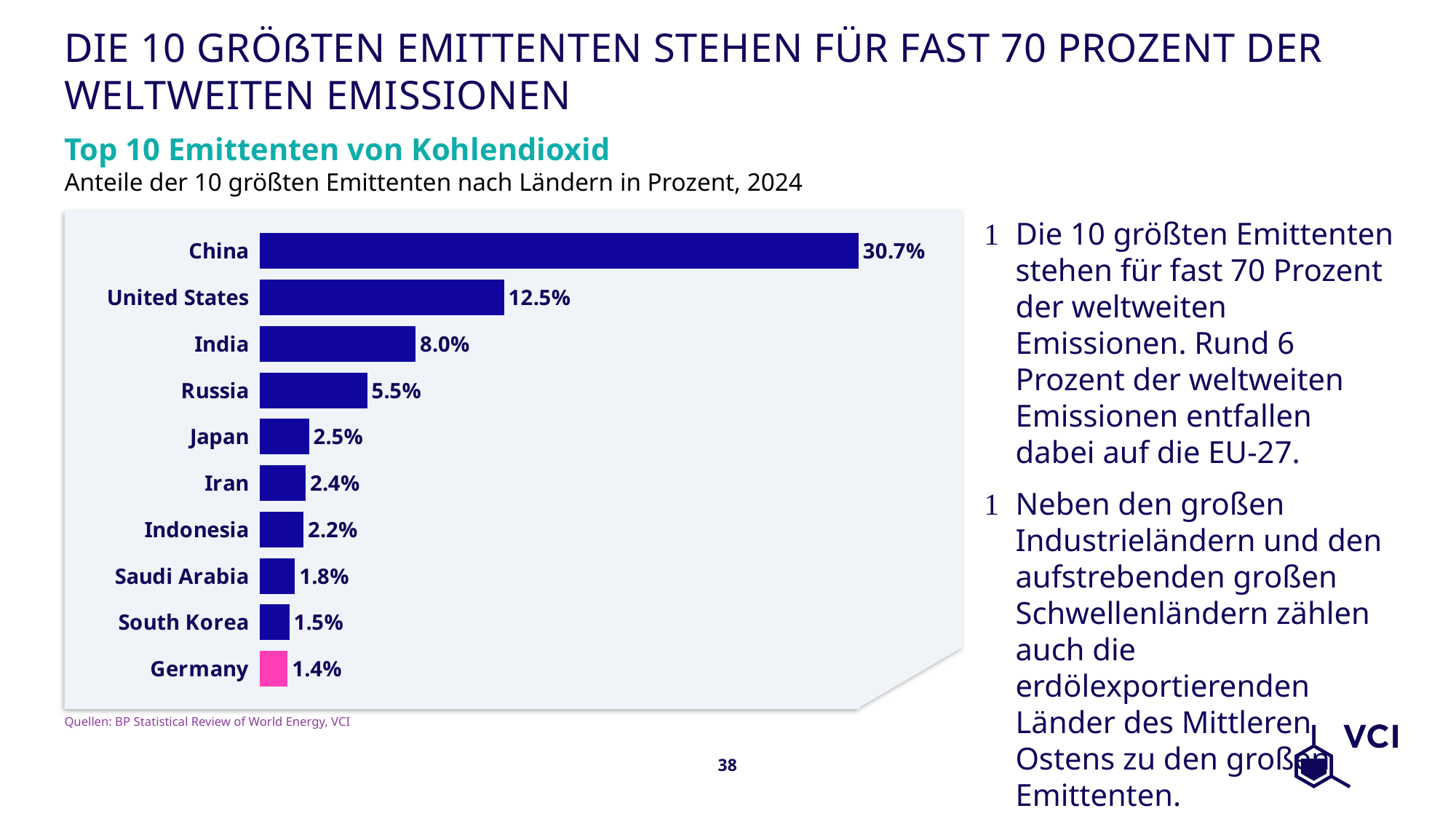
Which country has the lowest share? Germany Which has a larger share, Japan or Indonesia? Japan What kind of chart is shown? Bar chart What is the share for China? 30.7% Which country's bar is shown in a different colour (pink) from the others? Germany How many countries are shown in the chart? 10 What is the share for Germany? 1.4% What is the difference between the shares of China and the United States? 18.2% What is the share for India? 8.0% What is the difference between the shares of Russia and Japan? 3.0% Which has a larger share, Saudi Arabia or India? India Which country has the highest share? China